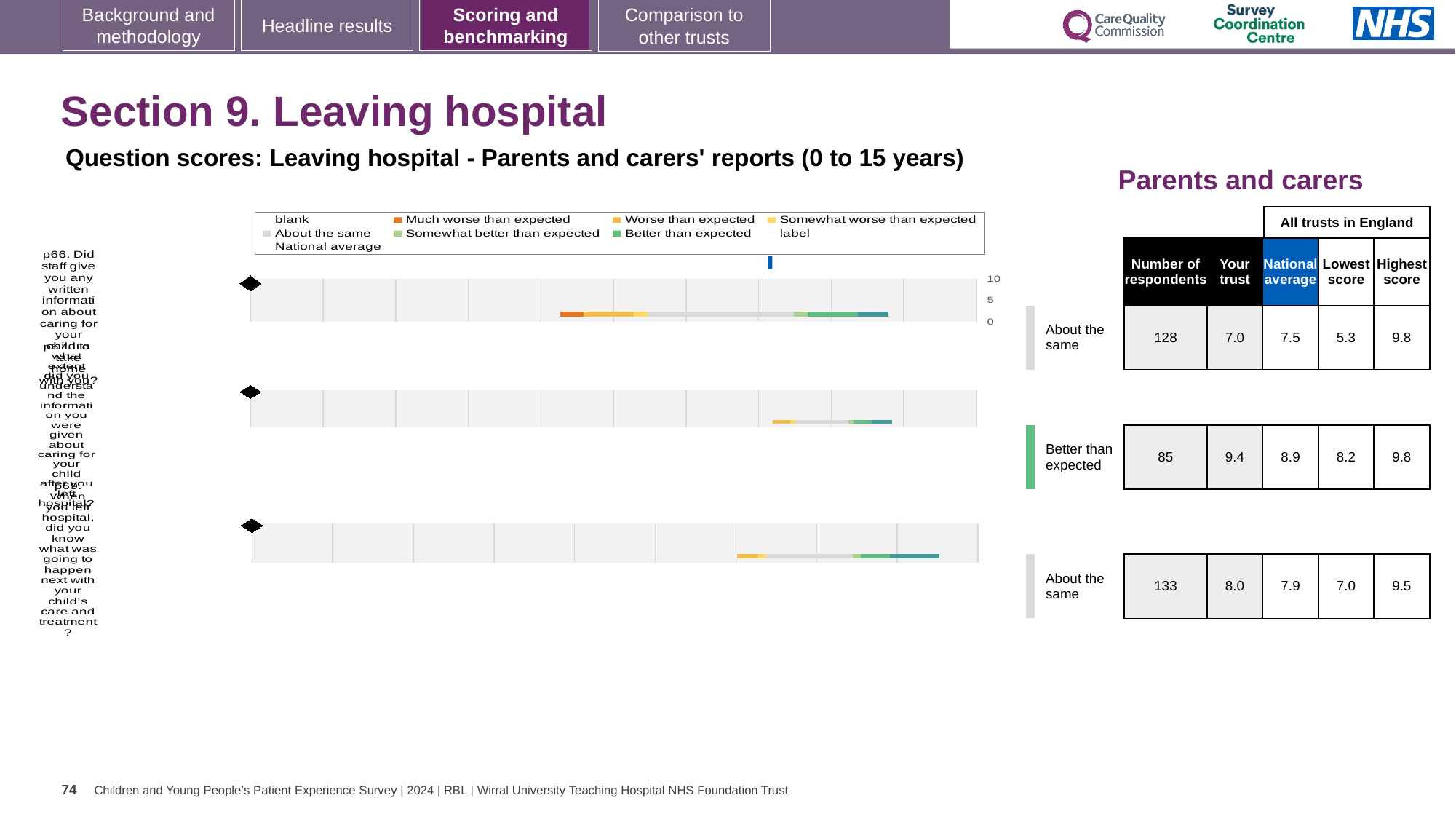
Which benchmark category is shown beside the middle bar chart? Better than expected What kind of chart is used for the question scores on this slide? bar chart What is the highest value shown on the score axis of the bar charts? 10 In the legend, which colour represents 'Much worse than expected'? orange How many question-score bar charts are shown on the slide? 3 What is the title of the question-score charts on this slide? Question scores: Leaving hospital - Parents and carers' reports (0 to 15 years) Which benchmark category is shown beside the bottom bar chart? About the same Which benchmark category is shown beside the top bar chart? About the same